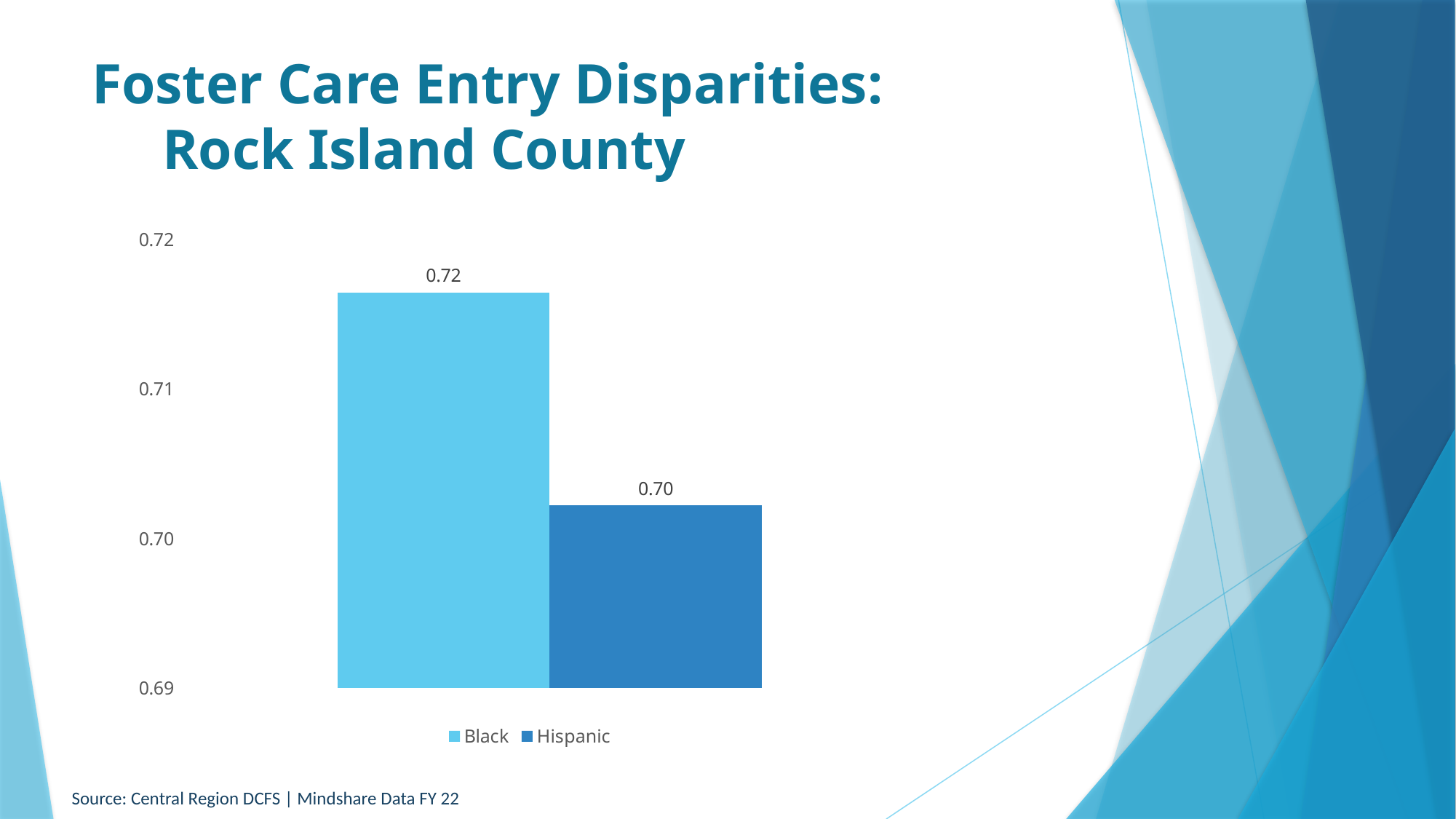
What is the value for Black? 0.72 What is the difference between the values for Black and Hispanic? 0.02 What is the value for Hispanic? 0.70 Is the value for Hispanic greater or less than 0.71? less How many bars are plotted on the chart? 2 Which group has the lowest value? Hispanic Which is larger, the value for Black or the value for Hispanic? Black What kind of chart is shown on the slide? bar chart How many series does the legend list? 2 What is the title of the slide? Foster Care Entry Disparities: Rock Island County Is the value for Black greater or less than 0.71? greater Which group has the highest value? Black